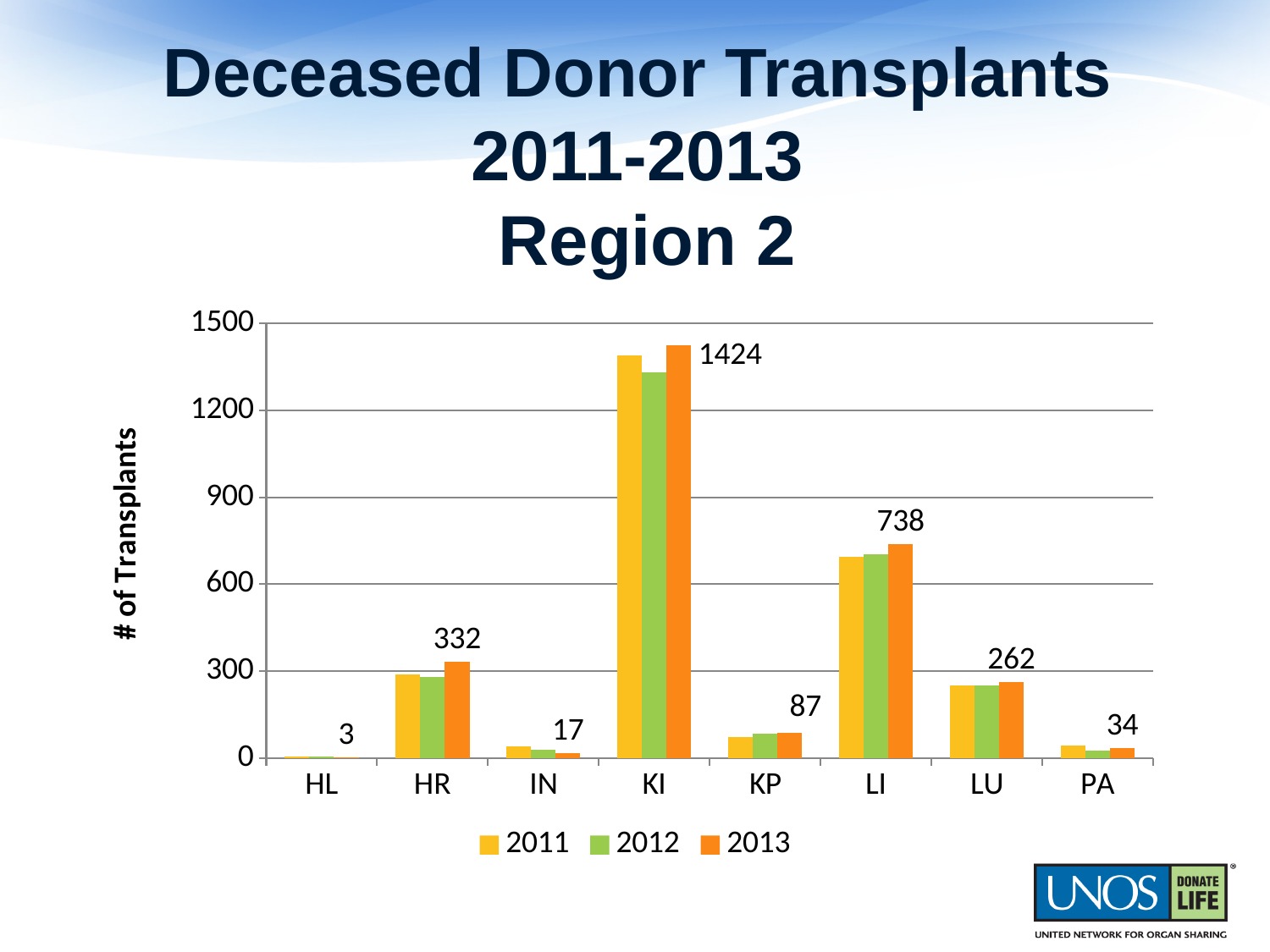
Which is larger in 2013, the value for HR or the value for LU? HR Which organ category has the lowest number of transplants in 2013? HL What is the 2013 value for LI? 738 How many series does the legend list? 3 What is the difference between the 2013 values for KI and LI? 686 What is the 2013 value for HR? 332 Is the 2011 value for KI greater or less than 1200? greater What is the 2013 value for KI? 1424 Which organ category has the highest number of transplants in 2013? KI What kind of chart is shown on the slide? Bar chart What is the 2013 value for PA? 34 How many organ categories are shown on the x axis? 8